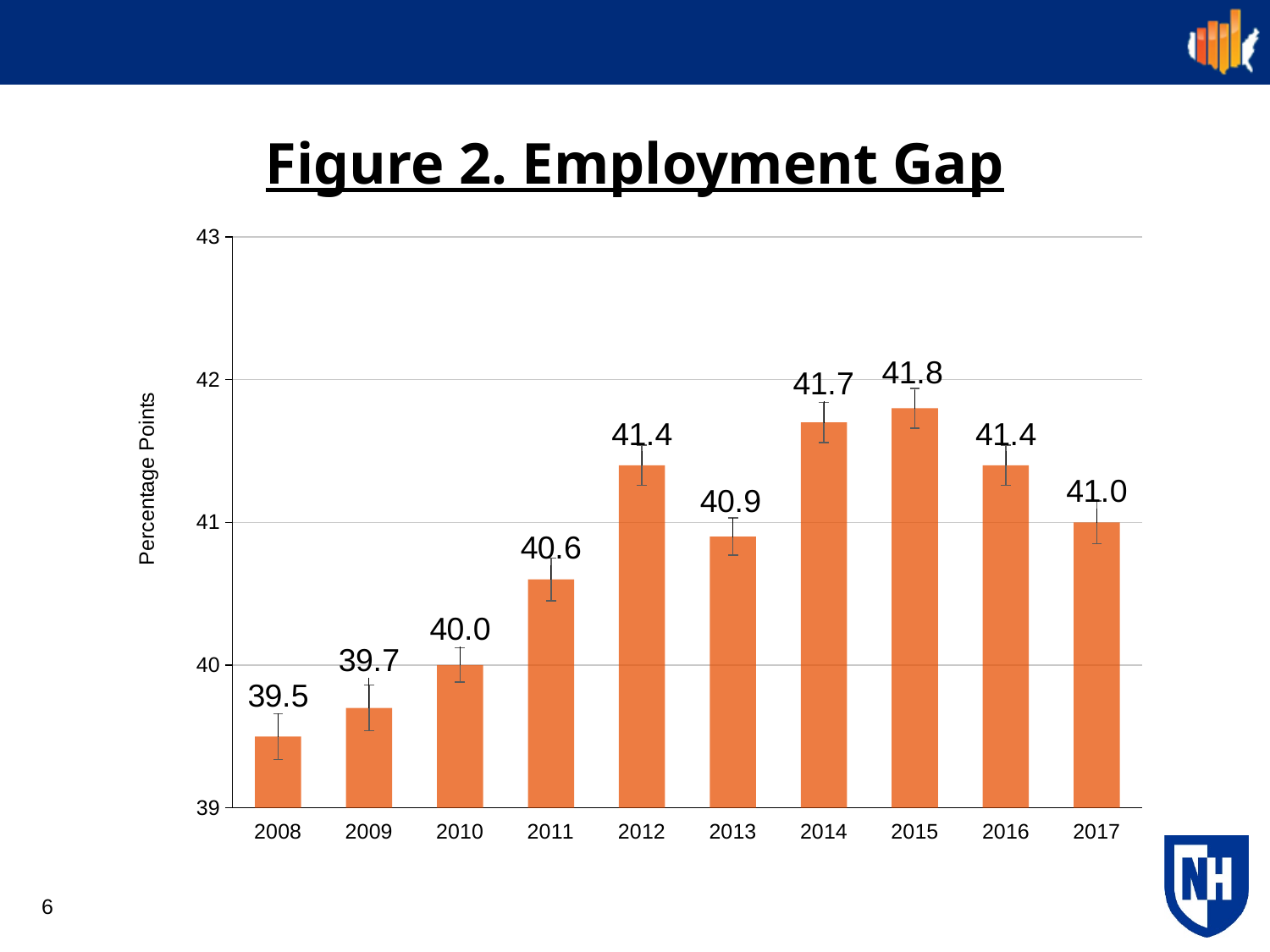
What is the difference between the employment gap in 2013 and in 2012? 0.5 Which year has the lowest employment gap? 2008 What is the employment gap value for 2012? 41.4 What is the employment gap value for 2008? 39.5 What is the difference between the employment gap in 2015 and in 2008? 2.3 Is the value for 2010 greater or less than 41? less How many years are shown on the x axis? 10 Which year has the highest employment gap? 2015 What is the employment gap value for 2017? 41.0 What is the label on the y axis? Percentage Points What kind of chart is shown on the slide? bar chart Which year has a larger employment gap, 2011 or 2014? 2014